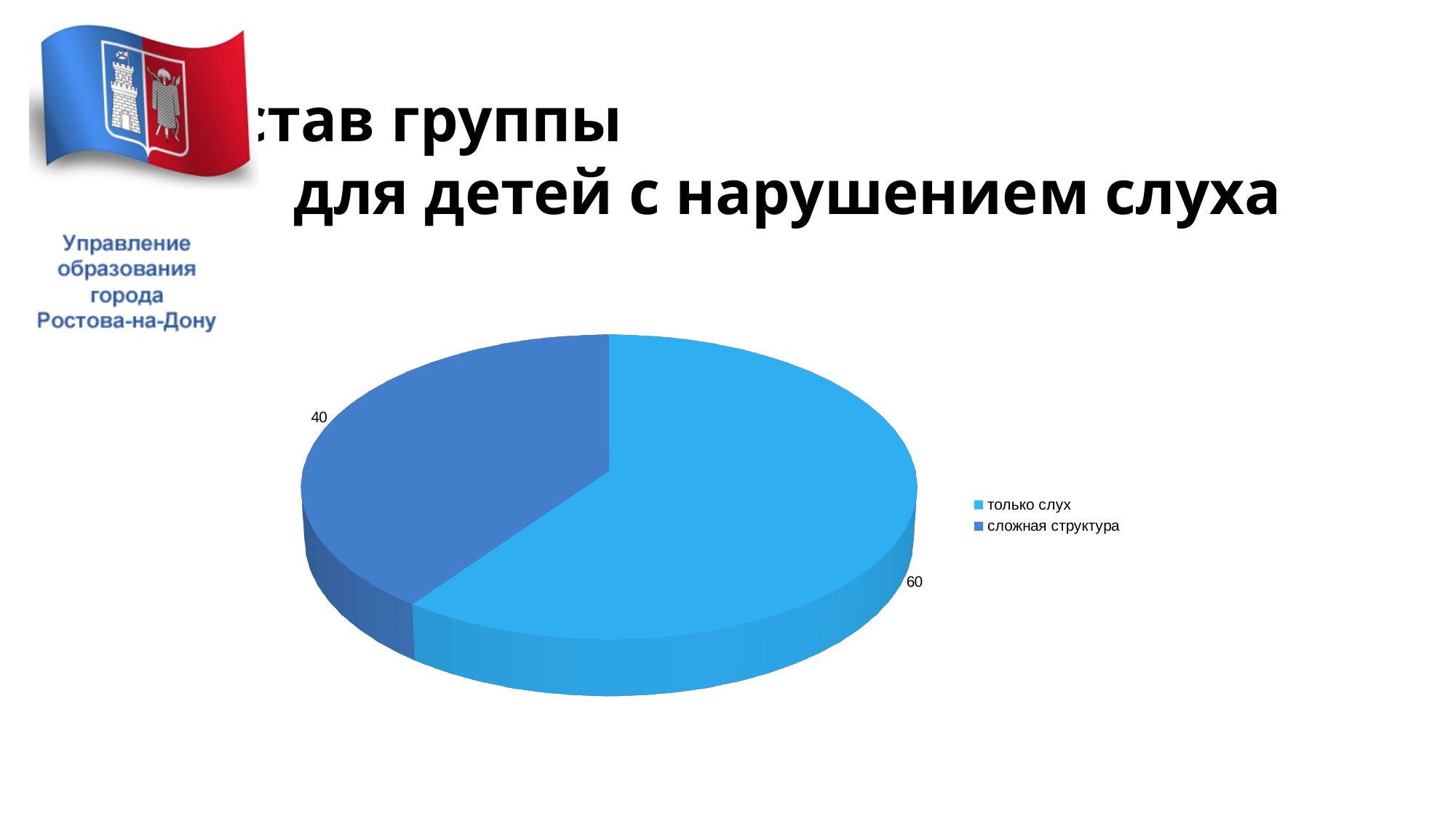
Which is larger: the value for "только слух" or for "сложная структура"? только слух How many slices does the pie chart have? 2 What colour is the slice for "сложная структура"? dark blue What is the value for "сложная структура"? 40 What kind of chart is shown on the slide? pie chart Which category has the smallest slice of the pie? сложная структура What share of the pie does "сложная структура" represent? 40% How many entries does the legend list? 2 Which category has the largest slice of the pie? только слух What is the value for "только слух"? 60 What share of the pie does "только слух" represent? 60% What is the difference between the values for "только слух" and "сложная структура"? 20